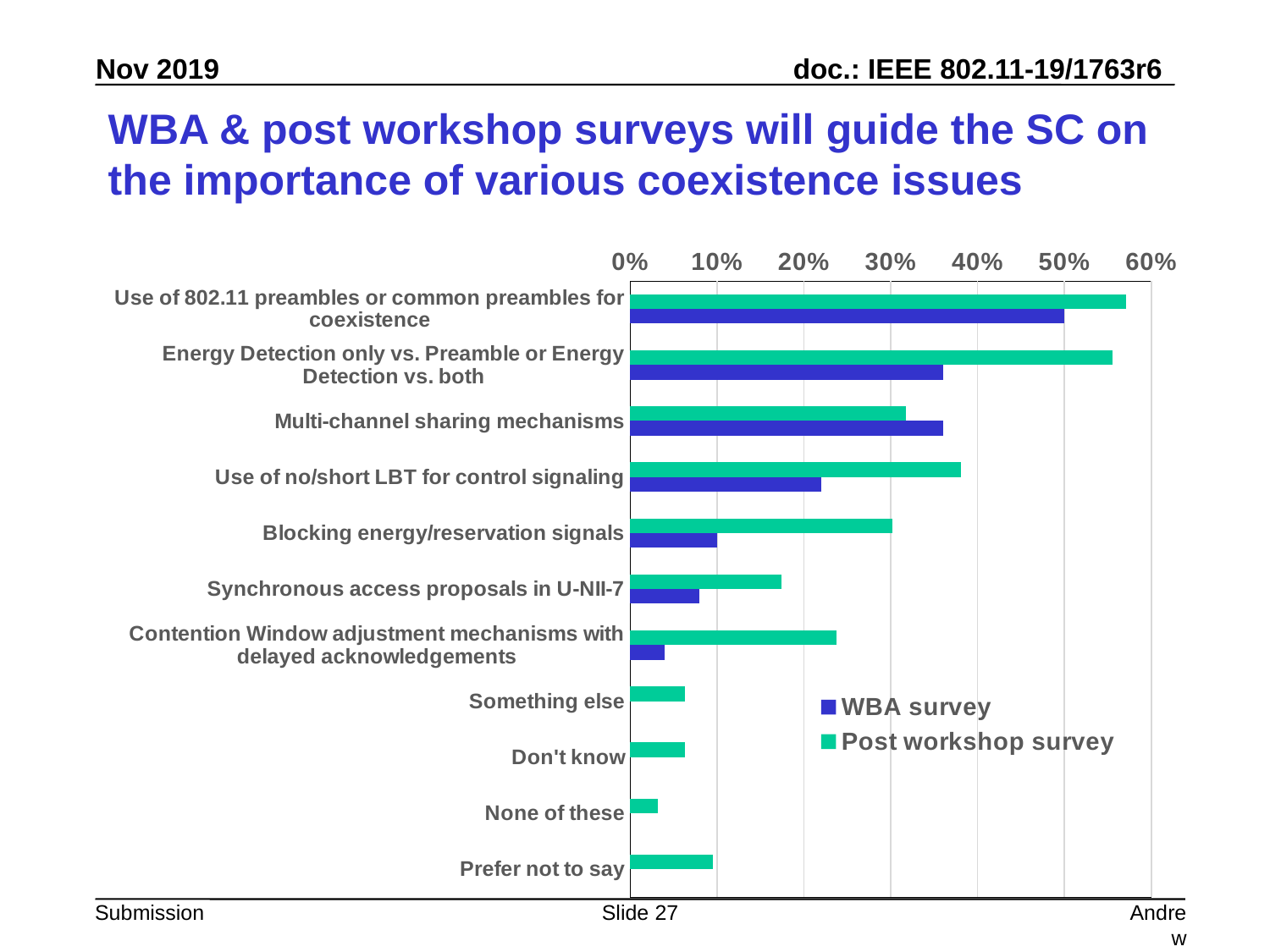
Is the WBA survey value for Energy Detection only vs. Preamble or Energy Detection vs. both greater or less than 30%? greater For Blocking energy/reservation signals, which series has the larger value, WBA survey or Post workshop survey? Post workshop survey Is the Post workshop survey value for Synchronous access proposals in U-NII-7 greater or less than 20%? less Which colour represents the WBA survey series in the legend? blue How many series does the legend list? 2 What kind of chart is shown on the slide? bar chart How many categories are plotted on the chart? 11 Which category has the lowest value for the Post workshop survey? None of these Is the WBA survey value for Contention Window adjustment mechanisms with delayed acknowledgements greater or less than 10%? less For Use of no/short LBT for control signaling, which series has the larger value, WBA survey or Post workshop survey? Post workshop survey Which category has the highest value for the WBA survey? Use of 802.11 preambles or common preambles for coexistence